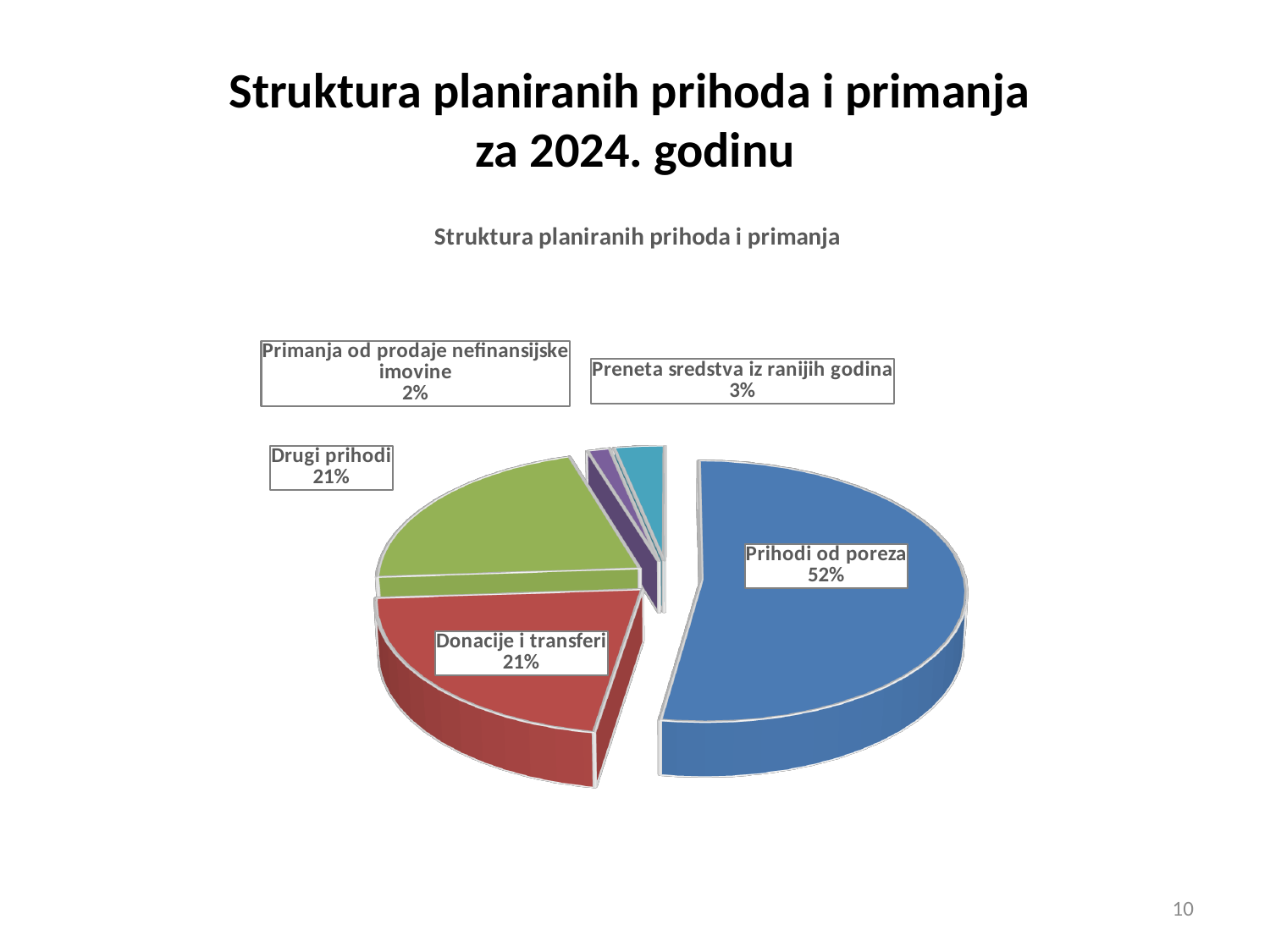
Which category has the largest share of the pie? Prihodi od poreza What is the title of the chart? Struktura planiranih prihoda i primanja What share of the pie is Preneta sredstva iz ranijih godina? 3% Which is larger, the share for Preneta sredstva iz ranijih godina or the share for Primanja od prodaje nefinansijske imovine? Preneta sredstva iz ranijih godina What share of the pie is Prihodi od poreza? 52% What is the difference in percentage points between Prihodi od poreza and Donacije i transferi? 31 What type of chart is shown on the slide? Pie chart What share of the pie is Donacije i transferi? 21% Which category has the smallest share of the pie? Primanja od prodaje nefinansijske imovine How many slices does the pie chart have? 5